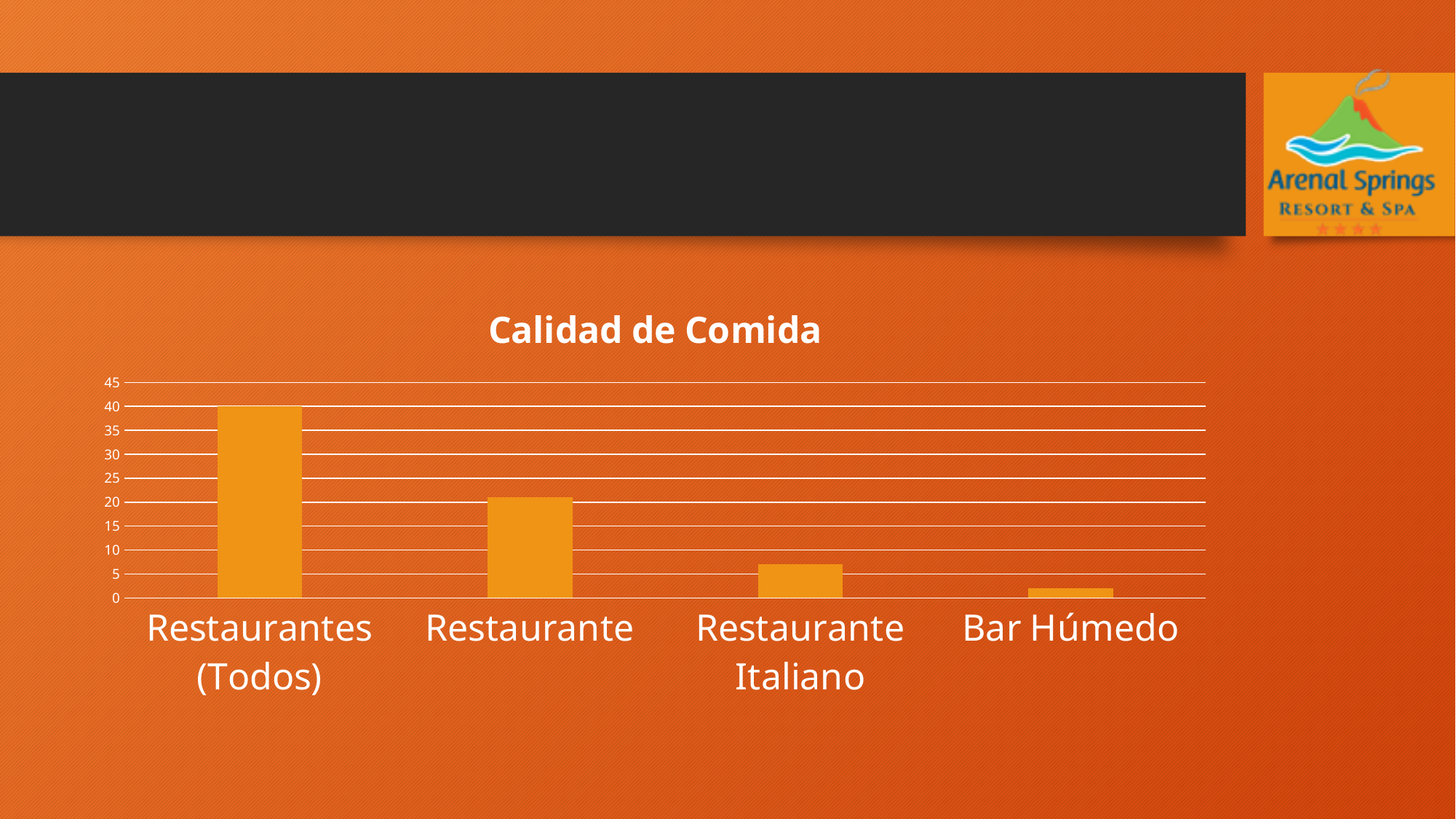
Which is larger, the value for Restaurante or the value for Restaurante Italiano? Restaurante How many categories are shown on the x axis of the chart? 4 What is the title of the chart? Calidad de Comida Is the value for Restaurante greater or less than 25? less Which category has the lowest value in the chart? Bar Húmedo Which category has the highest value in the chart? Restaurantes (Todos) Do the values rise or fall from left to right along the x axis? fall Is the value for Restaurante greater or less than 15? greater Is the value for Bar Húmedo greater or less than 5? less What kind of chart is shown on the slide? bar chart What is the value for Restaurantes (Todos)? 40